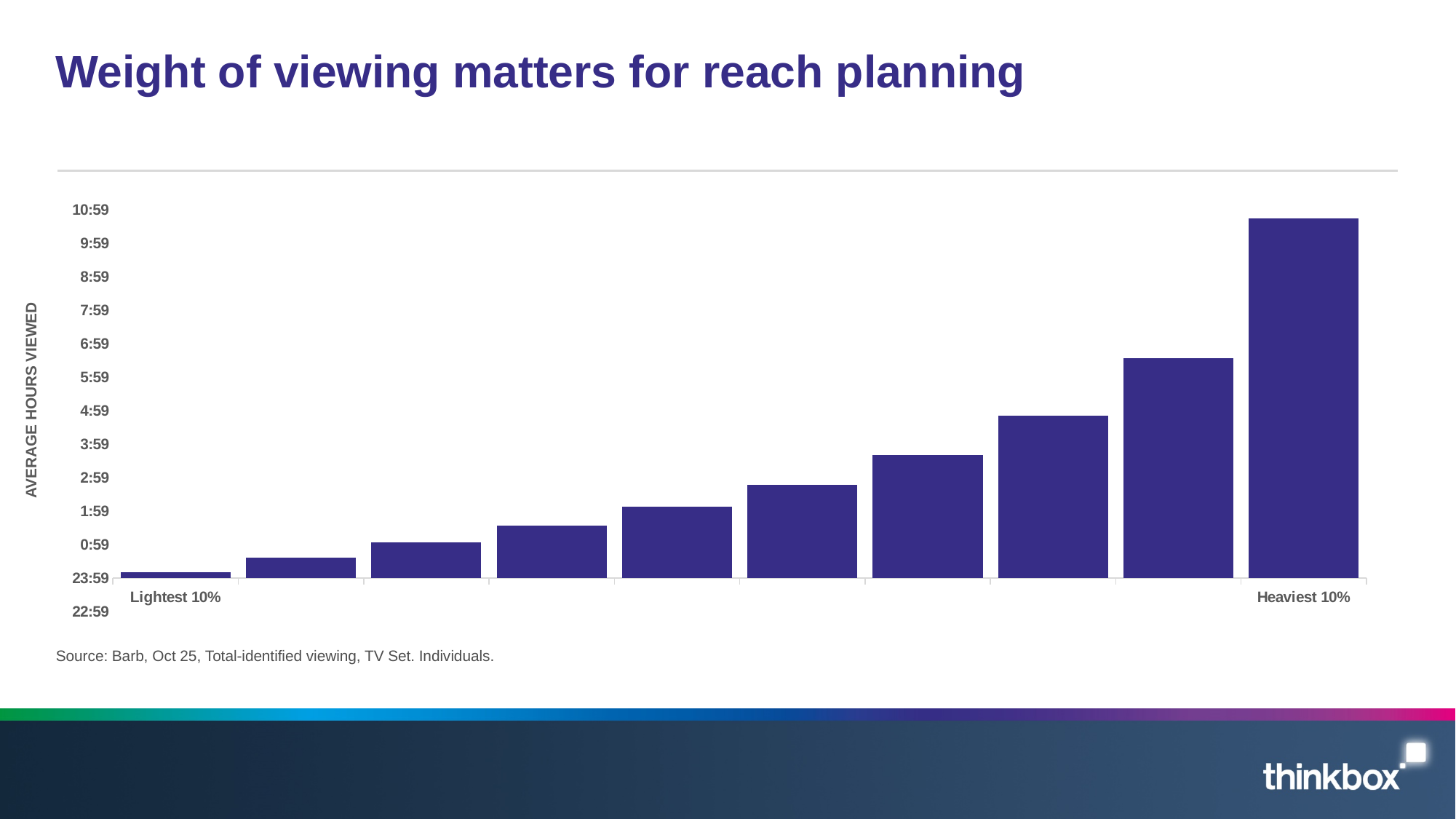
How many bars are plotted in the chart? 10 What kind of chart is shown on the slide? bar chart Is the value for Lightest 10% greater or less than 0:59? less Do the bar values rise or fall from left to right along the x axis? rise Which category has the lowest average hours viewed? Lightest 10% What is the title of the slide? Weight of viewing matters for reach planning What is the title of the y axis? AVERAGE HOURS VIEWED Which category has the highest average hours viewed? Heaviest 10% Is the value for Heaviest 10% greater or less than 7:59? greater Which has the larger value, Lightest 10% or Heaviest 10%? Heaviest 10% Is the value for Heaviest 10% greater or less than 9:59? greater